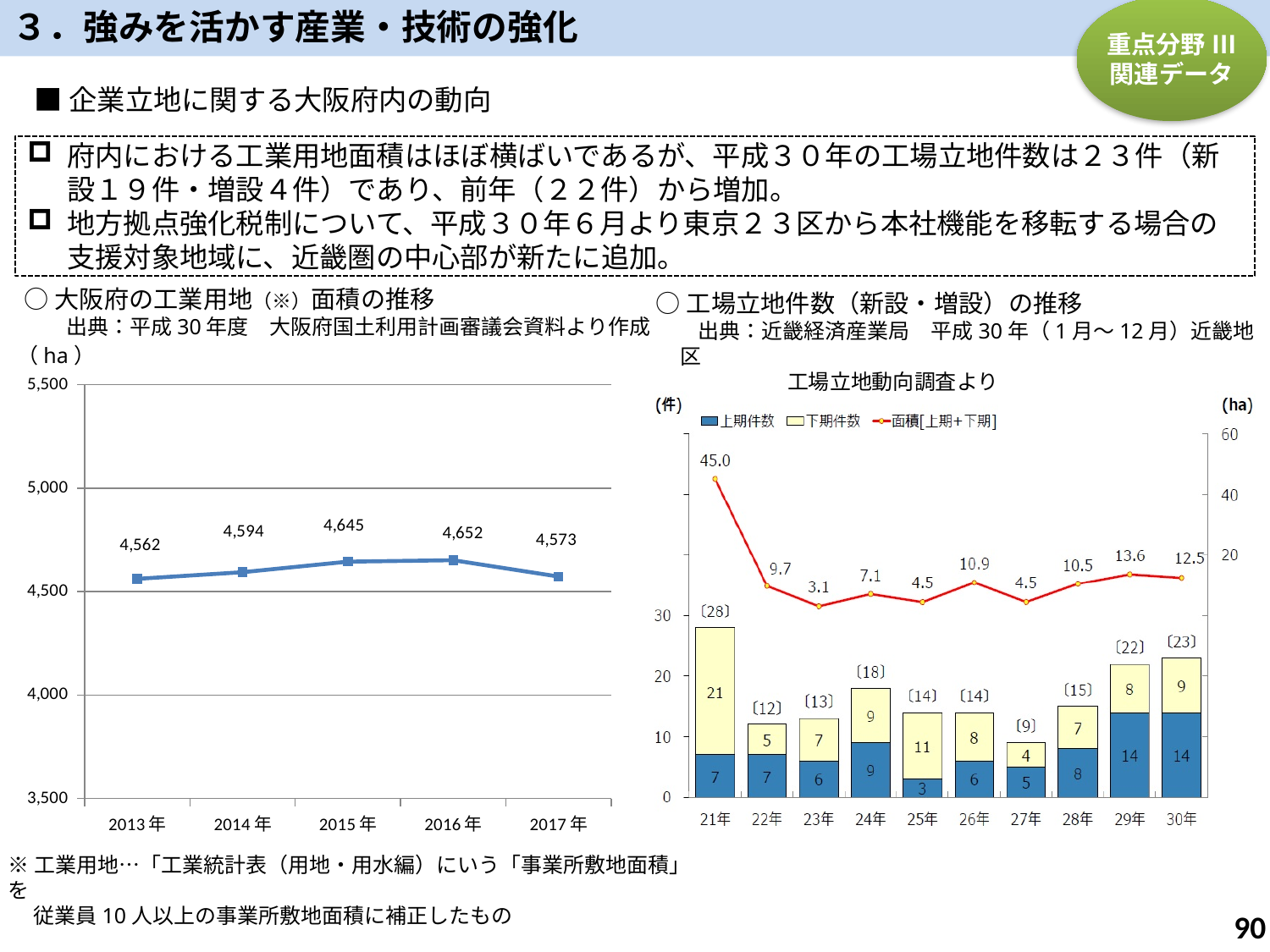
In the right chart (工場立地件数の推移), what is the total number of cases shown for 30年? 23 In the right chart (工場立地件数の推移), what is the 面積 value for 21年? 45.0 What kind of chart is the left chart (大阪府の工業用地面積の推移)? line chart In the left chart (大阪府の工業用地面積の推移), what is the difference between the 2016年 and 2017年 values? 79 In the right chart (工場立地件数の推移), what is the 上期件数 value for 29年? 14 In the left chart (大阪府の工業用地面積の推移), what is the value for 2015年? 4,645 In the right chart (工場立地件数の推移), is the 面積 value for 29年 larger or smaller than the value for 30年? larger In the left chart (大阪府の工業用地面積の推移), which year has the lowest value? 2013年 In the left chart (大阪府の工業用地面積の推移), how many years are plotted? 5 In the left chart (大阪府の工業用地面積の推移), which year has the highest value? 2016年 In the right chart (工場立地件数の推移), how many series does the legend list? 3 In the right chart (工場立地件数の推移), which year has the lowest total number of cases? 27年